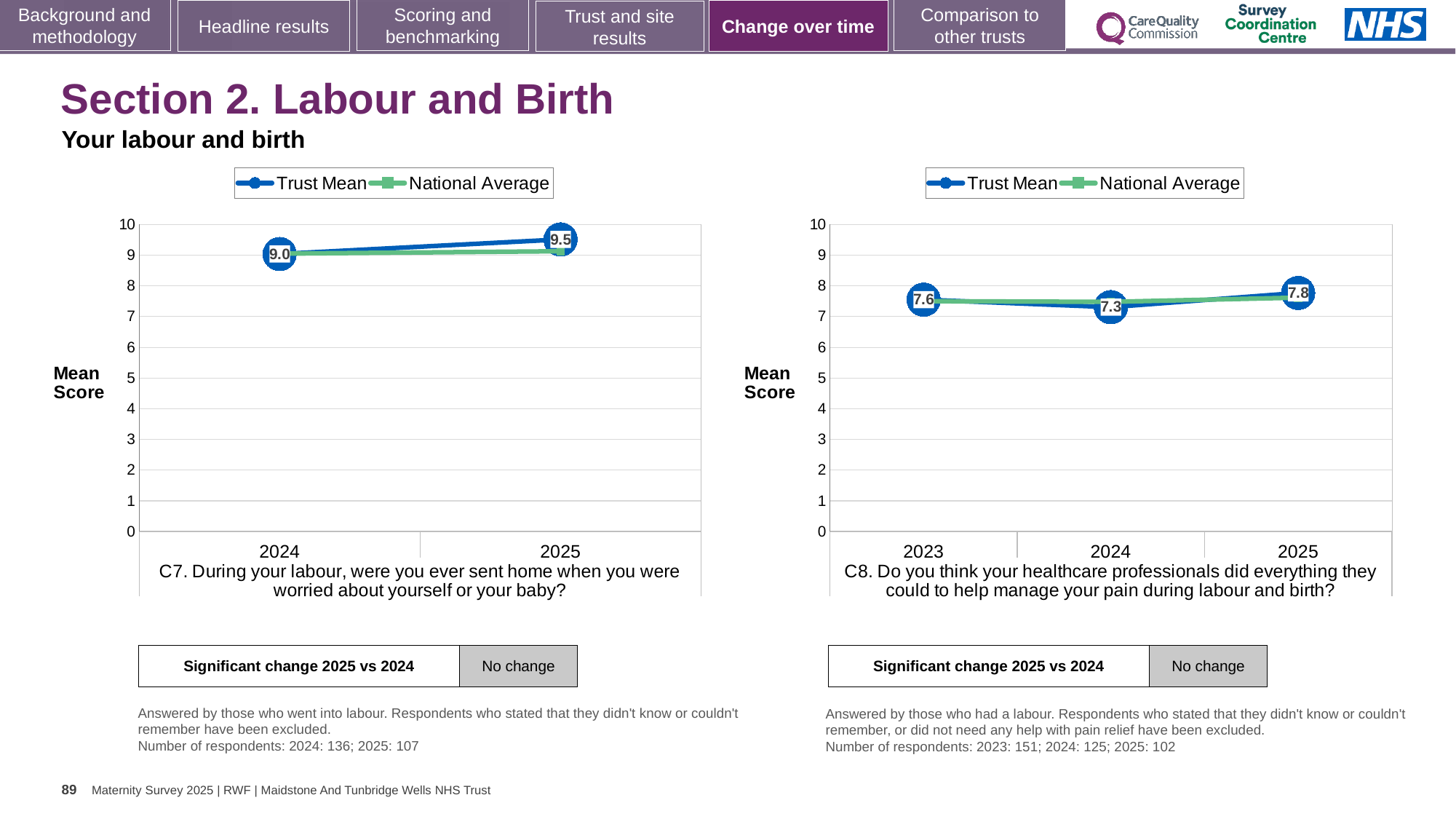
In the right chart (C8), how many years are shown on the x axis? 3 In the right chart (C8), which year has the lowest Trust Mean score? 2024 In the left chart (C7), by how much did the Trust Mean change from 2024 to 2025? 0.5 What type of chart is the right chart (C8)? line chart In the left chart (C7), what is the Trust Mean score for 2024? 9.0 In the left chart (C7), what is the Trust Mean score for 2025? 9.5 In the right chart (C8), what is the Trust Mean score for 2023? 7.6 In the right chart (C8), what is the difference between the Trust Mean scores for 2025 and 2024? 0.5 How many series does the legend of the left chart (C7) list? 2 In the right chart (C8), what is the Trust Mean score for 2024? 7.3 In the left chart (C7), does the Trust Mean rise or fall from 2024 to 2025? rise In the right chart (C8), which year has the highest Trust Mean score? 2025